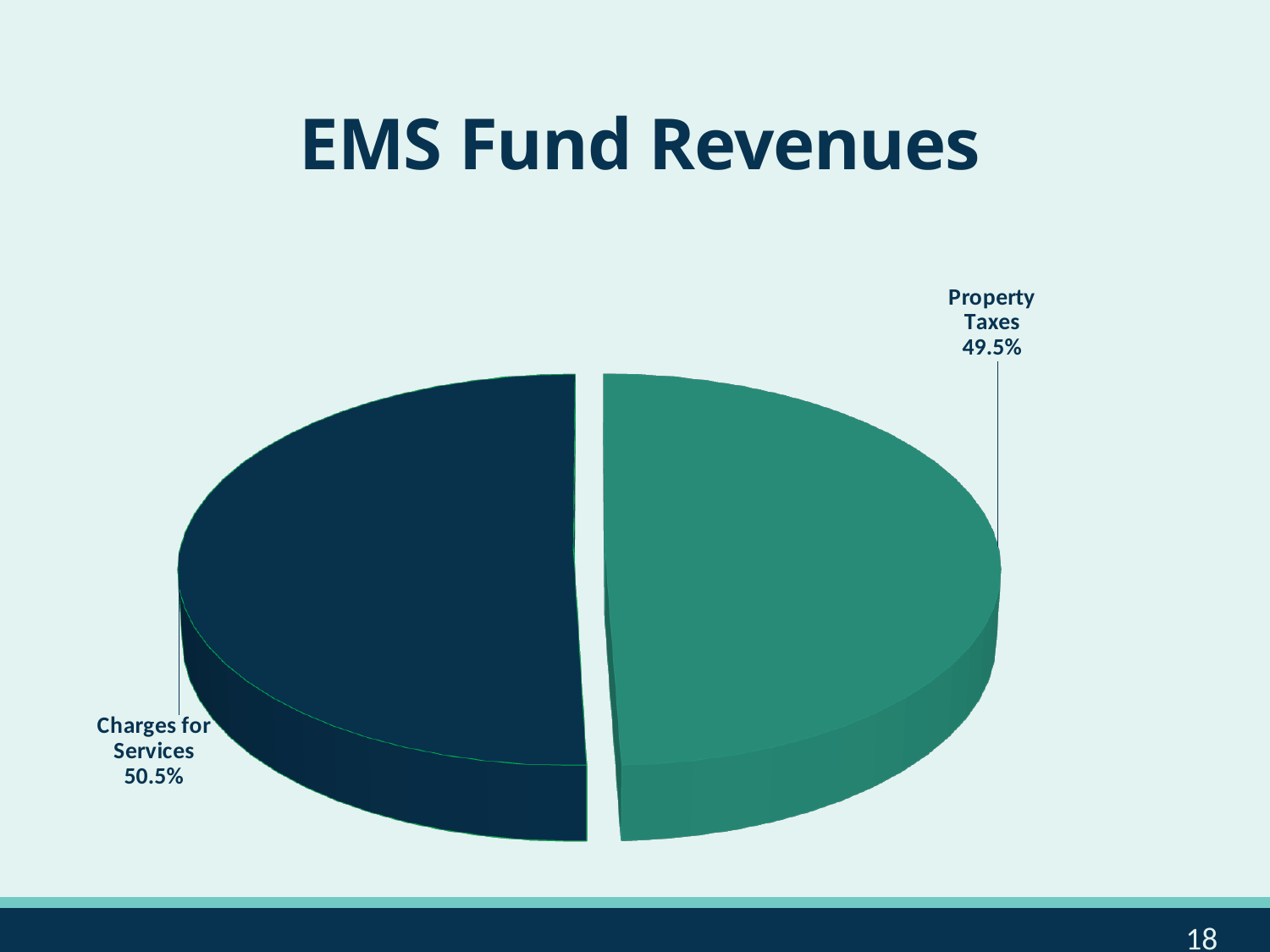
Which revenue source has the larger share of EMS Fund Revenues? Charges for Services What is the difference in percentage points between the Charges for Services share and the Property Taxes share? 1 percentage point What kind of chart is shown on the slide? pie chart How many slices does the pie chart have? 2 Which slice of the pie is shown in dark navy blue? Charges for Services Is the share for Property Taxes greater or less than 50%? less Which revenue source has the smaller share of EMS Fund Revenues? Property Taxes What is the combined share of Property Taxes and Charges for Services? 100% What share of EMS Fund Revenues comes from Charges for Services? 50.5% What is the title of the chart? EMS Fund Revenues Is the share for Charges for Services larger or smaller than the share for Property Taxes? larger What share of EMS Fund Revenues comes from Property Taxes? 49.5%